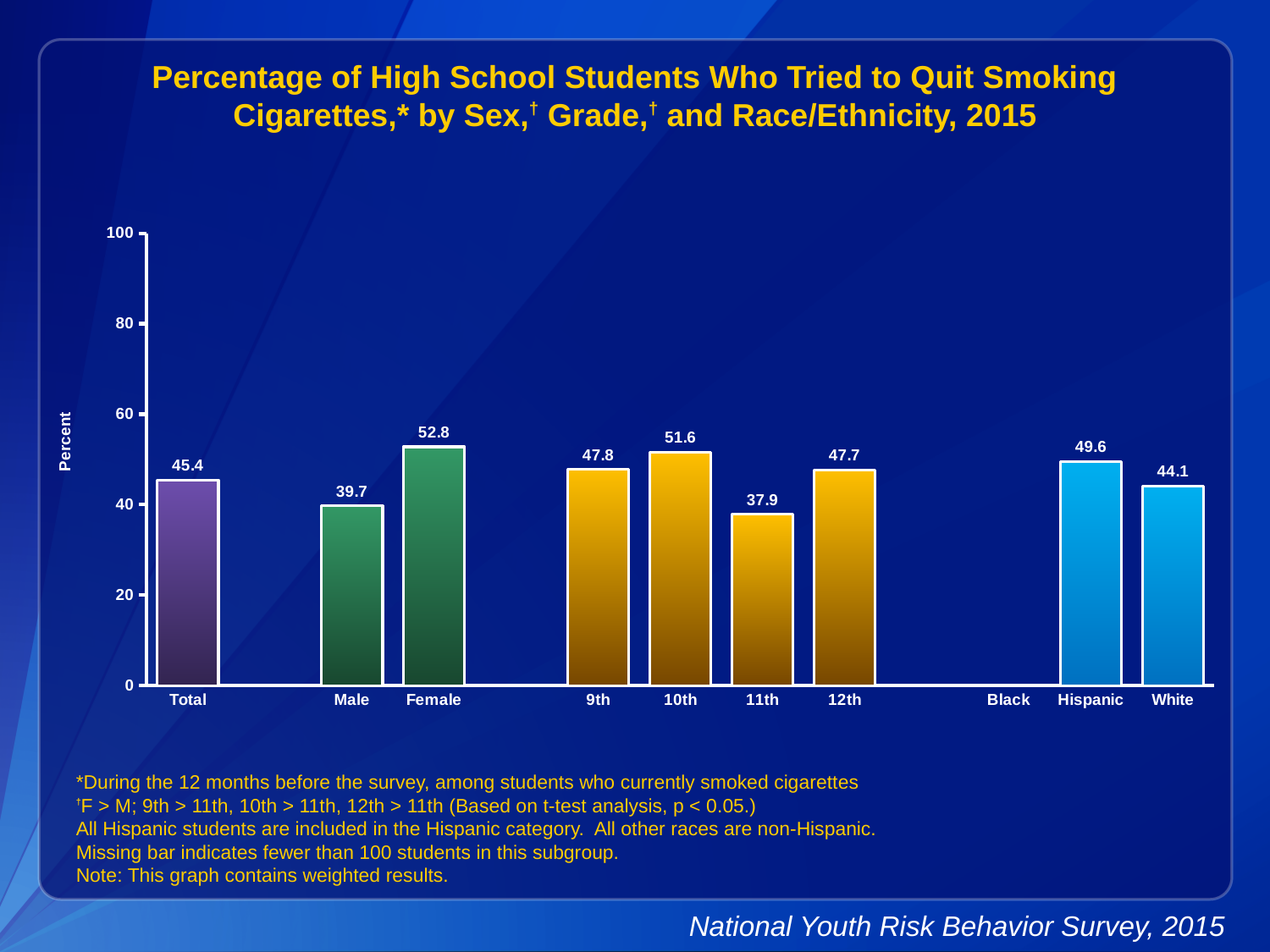
Which category has the lowest value among the bars shown? 11th Which category has the highest value? Female How many bars are plotted on the chart? 9 What is the value for Female? 52.8 Which is larger, the value for 10th grade or the value for 12th grade? 10th Is the value for Male greater or less than 40? less Which category label has no bar plotted? Black What is the value for Total? 45.4 What is the difference between the Female and Male values? 13.1 What is the value for Hispanic? 49.6 What is the value for 11th grade? 37.9 What kind of chart is shown? bar chart